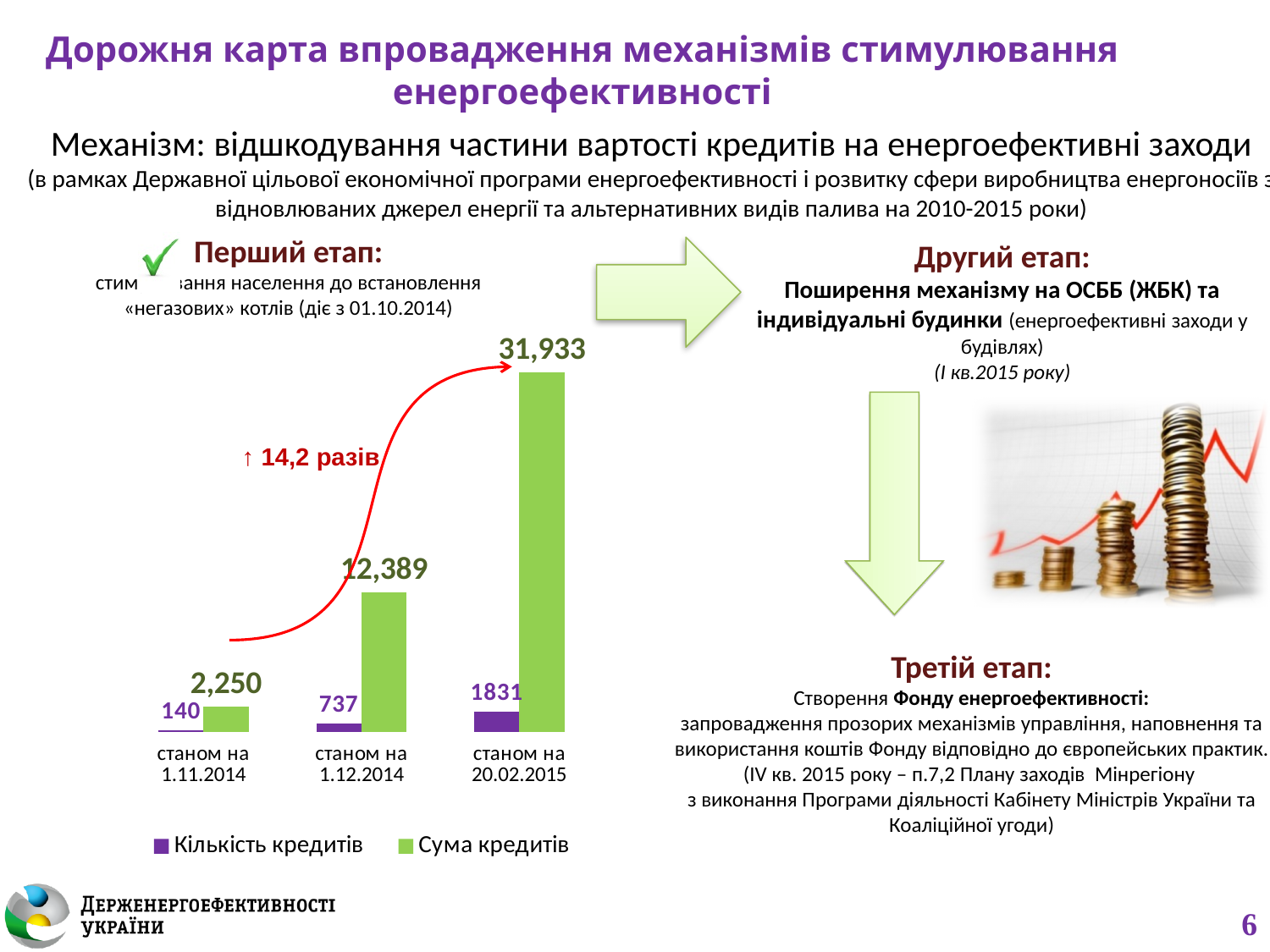
How many series does the chart legend list? 2 What is the value of "Кількість кредитів" for "станом на 1.12.2014"? 737 How many categories are shown on the x axis of the chart? 3 Which category has the highest value for "Сума кредитів"? станом на 20.02.2015 What is the value of "Сума кредитів" for "станом на 1.12.2014"? 12,389 Which is larger: "Сума кредитів" for "станом на 1.11.2014" or "Кількість кредитів" for "станом на 20.02.2015"? Сума кредитів for станом на 1.11.2014 What is the value of "Кількість кредитів" for "станом на 1.11.2014"? 140 What kind of chart is shown on the slide? bar chart What is the difference between "Кількість кредитів" for "станом на 20.02.2015" and "станом на 1.11.2014"? 1691 Which category has the lowest value for "Кількість кредитів"? станом на 1.11.2014 What is the value of "Сума кредитів" for "станом на 20.02.2015"? 31,933 What is the difference between "Сума кредитів" for "станом на 20.02.2015" and "станом на 1.12.2014"? 19,544